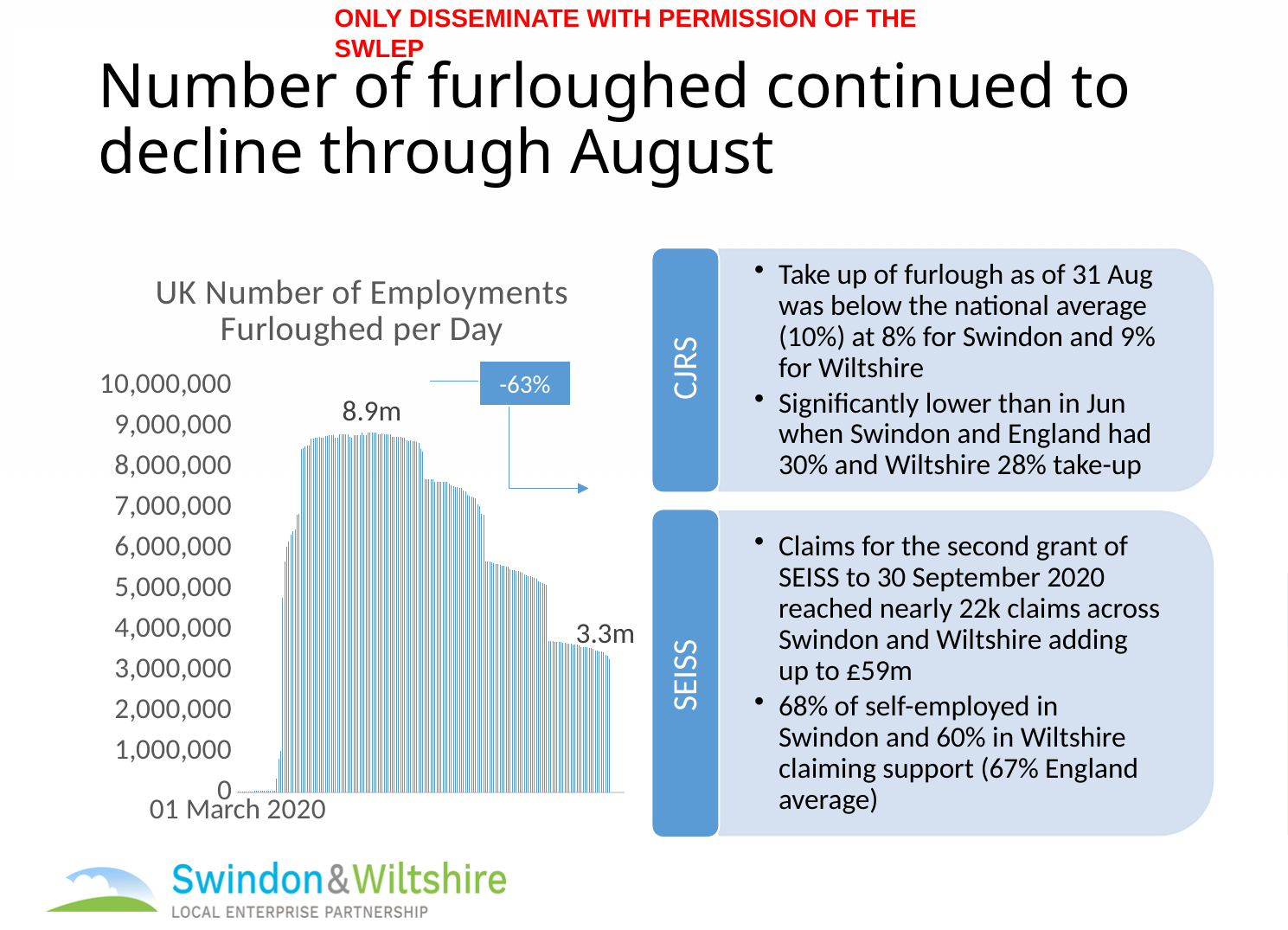
Is the final value on the chart greater or less than 4,000,000? less What is the peak value labelled on the chart? 8.9m What type of chart is shown on the slide? bar chart Is the peak value on the chart greater or less than 8,000,000? greater What percentage change is shown in the annotation box on the chart? -63% What is the difference between the labelled peak value and the labelled final value? 5.6m What is the value labelled at the right-hand end of the chart? 3.3m After reaching the peak, do the values rise or fall along the x axis? fall Which is larger, the peak value of 8.9m or the final value of 3.3m? 8.9m What date is shown as the first label on the horizontal axis? 01 March 2020 What is the highest value shown on the vertical axis? 10,000,000 What is the title of the chart? UK Number of Employments Furloughed per Day